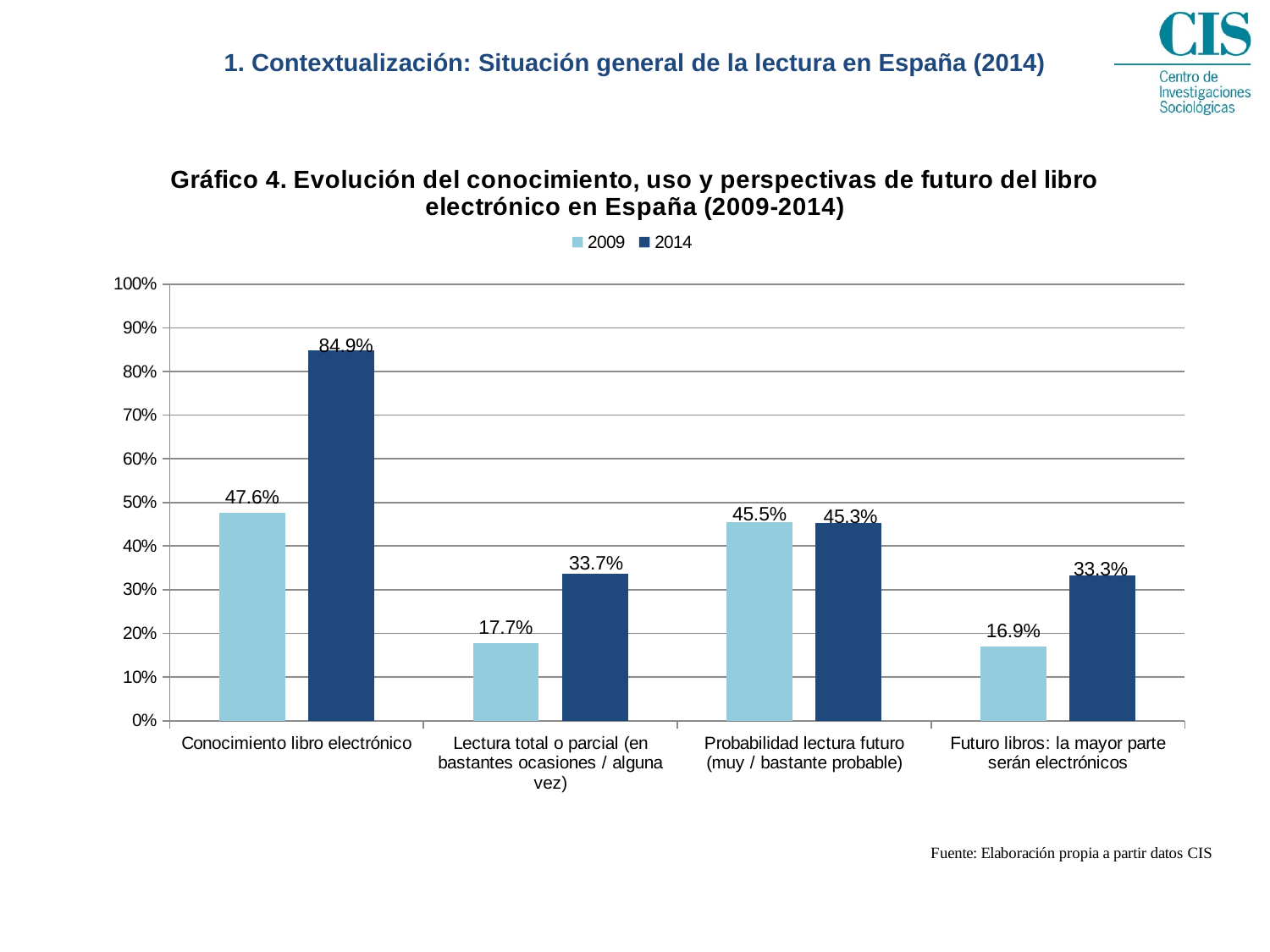
How many categories are shown on the x axis? 4 For Lectura total o parcial, which is larger: the 2009 value or the 2014 value? 2014 What is the 2014 value for Probabilidad lectura futuro (muy / bastante probable)? 45.3% What is the 2014 value for Conocimiento libro electrónico? 84.9% What is the difference between the 2014 and 2009 values for Conocimiento libro electrónico? 37.3% What is the 2009 value for Futuro libros: la mayor parte serán electrónicos? 16.9% How many series does the legend list? 2 What is the difference between the 2009 and 2014 values for Probabilidad lectura futuro (muy / bastante probable)? 0.2% What is the 2009 value for Lectura total o parcial (en bastantes ocasiones / alguna vez)? 17.7% Which category has the highest 2014 value? Conocimiento libro electrónico Is the 2014 value for Futuro libros: la mayor parte serán electrónicos greater or less than 30%? greater Which category has the lowest 2009 value? Futuro libros: la mayor parte serán electrónicos